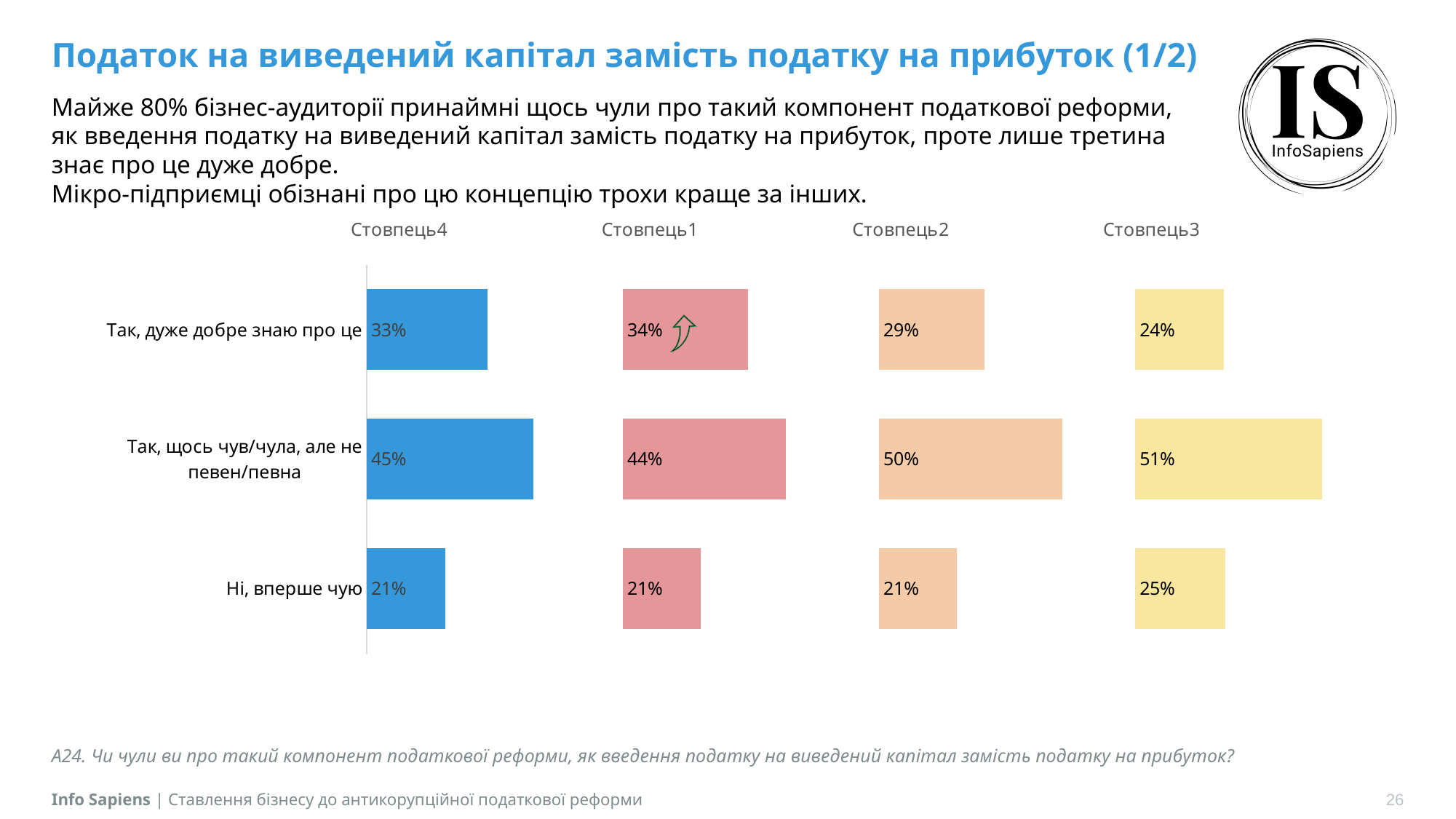
What is the value for "Так, дуже добре знаю про це" in the Стовпець4 series? 33% What is the value for "Ні, вперше чую" in the Стовпець2 series? 21% Which is larger for "Так, щось чув/чула, але не певен/певна": the Стовпець4 value or the Стовпець3 value? Стовпець3 What is the value for "Так, дуже добре знаю про це" in the Стовпець1 series? 34% What colour are the bars of the Стовпець4 series? Blue How many categories are shown on the chart? 3 What kind of chart is shown on the slide? Bar chart What is the difference between the Стовпець3 and Стовпець4 values for "Так, дуже добре знаю про це"? 9% What is the value for "Так, щось чув/чула, але не певен/певна" in the Стовпець3 series? 51% Which category has the highest value in the Стовпець2 series? Так, щось чув/чула, але не певен/певна Which category has the lowest value in the Стовпець4 series? Ні, вперше чую How many series does the chart show? 4